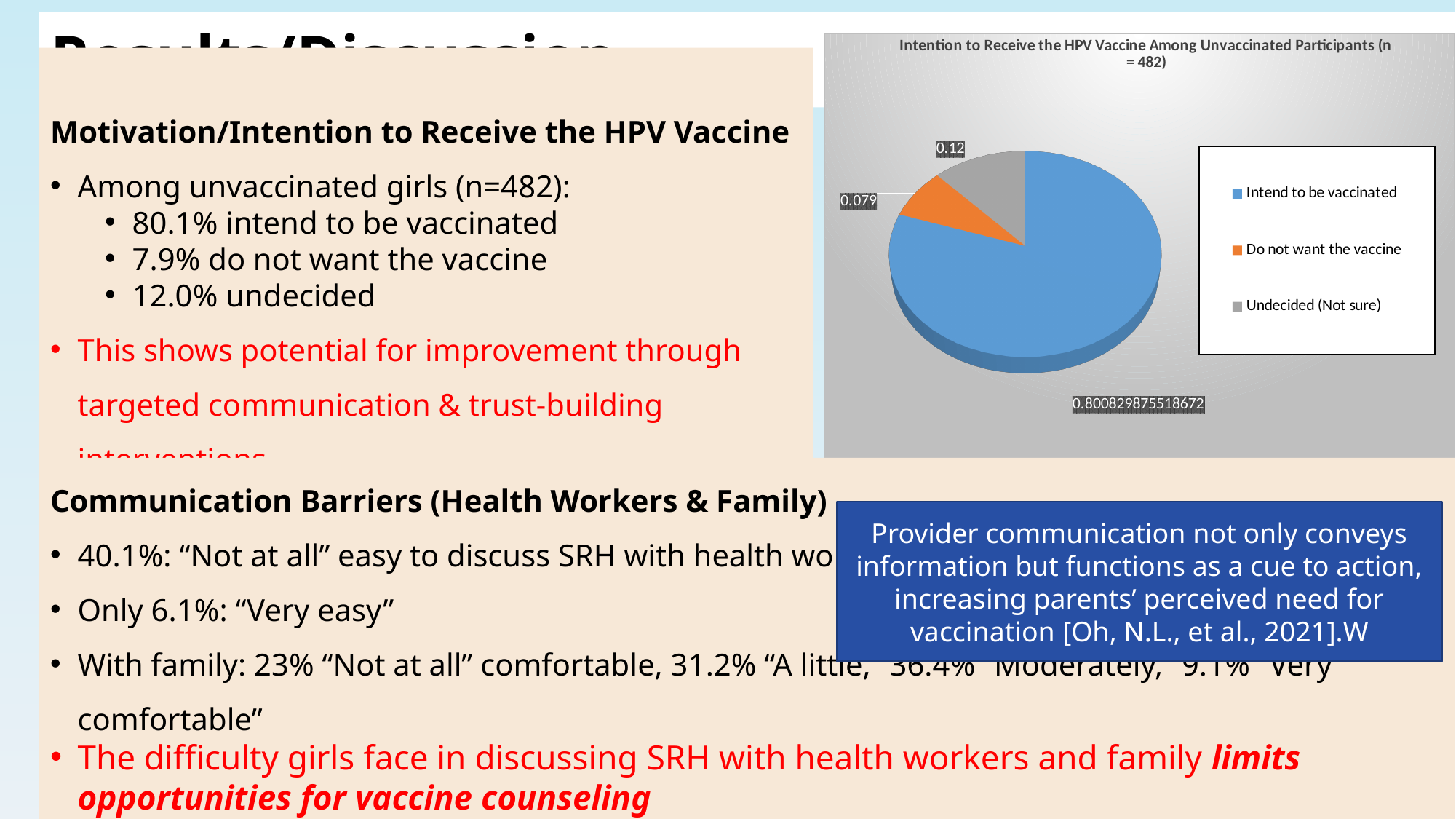
What colour is the 'Do not want the vaccine' slice in the pie chart? Orange Which category has the smallest slice of the pie? Do not want the vaccine Which slice is larger: 'Undecided (Not sure)' or 'Do not want the vaccine'? Undecided (Not sure) How many entries does the legend of the pie chart list? 3 What is the difference between the 'Undecided (Not sure)' value and the 'Do not want the vaccine' value? 0.041 What value is labelled on the 'Undecided (Not sure)' slice? 0.12 What kind of chart is shown on the slide? Pie chart What is the title of the pie chart? Intention to Receive the HPV Vaccine Among Unvaccinated Participants (n = 482) What value is labelled on the 'Intend to be vaccinated' slice? 0.800829875518672 How many slices does the pie chart have? 3 Which category has the largest slice of the pie? Intend to be vaccinated What value is labelled on the 'Do not want the vaccine' slice? 0.079